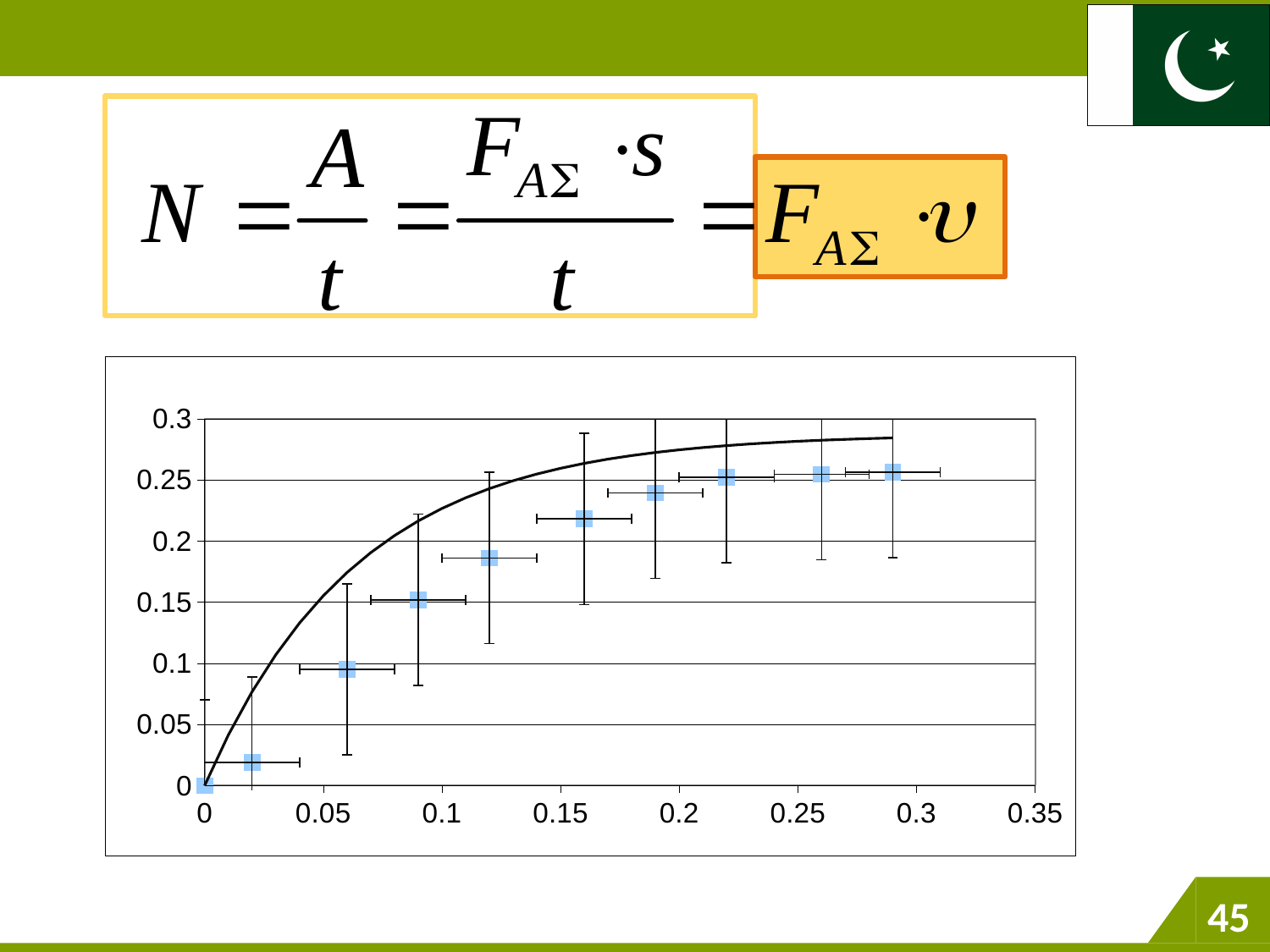
What is the highest value shown on the x axis? 0.35 Do the plotted values rise or fall as the x value increases? rise Is the y value of the point at x = 0.12 greater or less than 0.15? greater Which has the larger y value, the point at x = 0.06 or the point at x = 0.12? the point at x = 0.12 Is the y value of the point at x = 0.02 greater or less than 0.05? less Which data point has the lowest y value? the point at x = 0 What kind of chart is shown on the slide? scatter chart Is the y value of the point at x = 0.09 greater or less than 0.2? less Do the data points have error bars? yes How many data points are plotted on the chart? 10